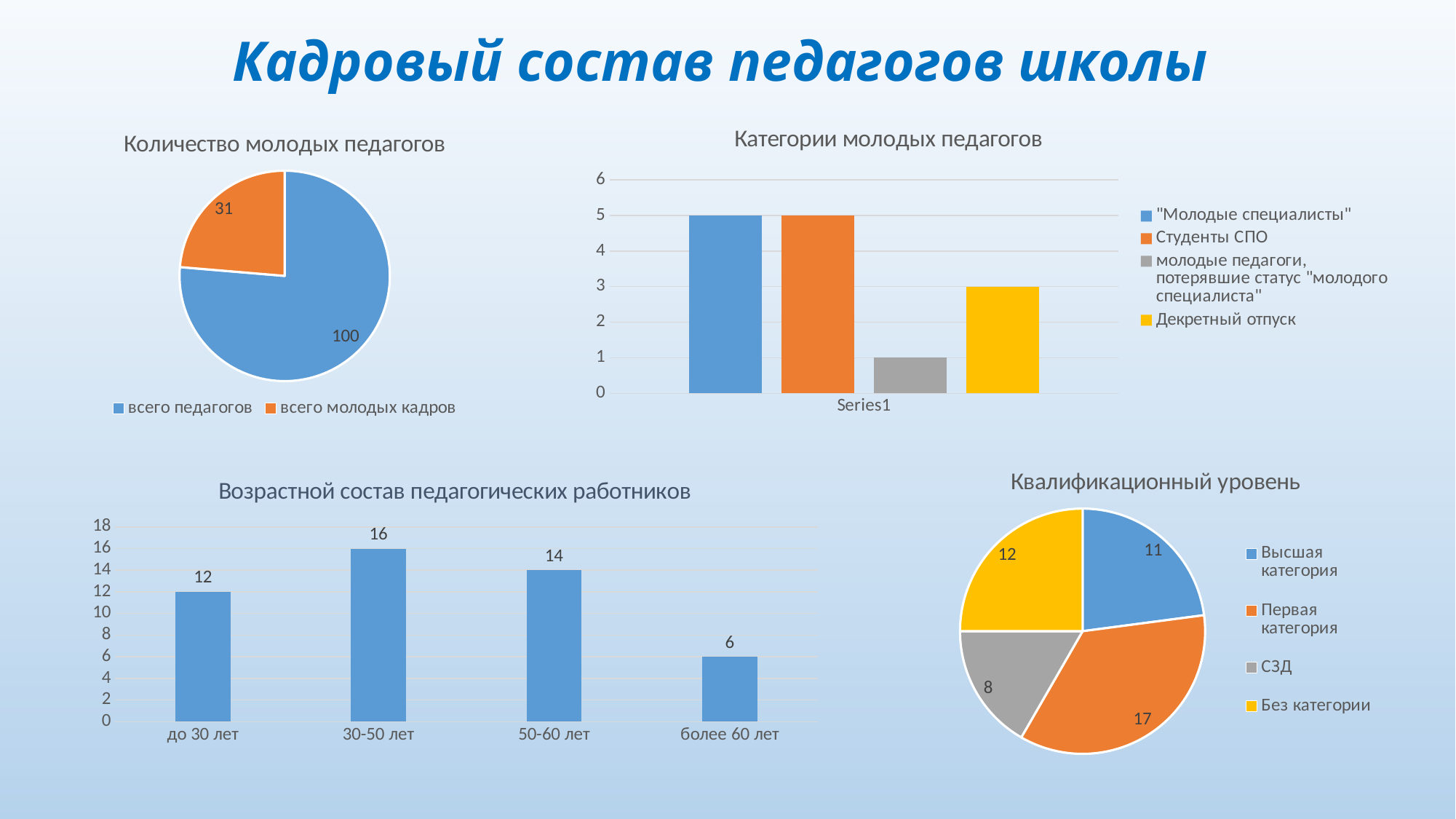
In the chart titled "Категории молодых педагогов", how many series does the legend list? 4 In the chart titled "Возрастной состав педагогических работников", which age group has the highest value? 30-50 лет In the chart titled "Категории молодых педагогов", what is the value for "Декретный отпуск"? 3 In the chart titled "Квалификационный уровень", what is the value for "СЗД"? 8 What kind of chart is "Квалификационный уровень"? Pie chart In the chart titled "Возрастной состав педагогических работников", how many age categories are shown? 4 In the chart titled "Количество молодых педагогов", what is the value for "всего молодых кадров"? 31 In the chart titled "Квалификационный уровень", which is larger: "Высшая категория" or "Первая категория"? Первая категория In the chart titled "Возрастной состав педагогических работников", what is the difference between "30-50 лет" and "более 60 лет"? 10 In the chart titled "Категории молодых педагогов", which category has the lowest value? молодые педагоги, потерявшие статус "молодого специалиста" In the chart titled "Возрастной состав педагогических работников", what is the value for "50-60 лет"? 14 In the chart titled "Количество молодых педагогов", what is the value for "всего педагогов"? 100